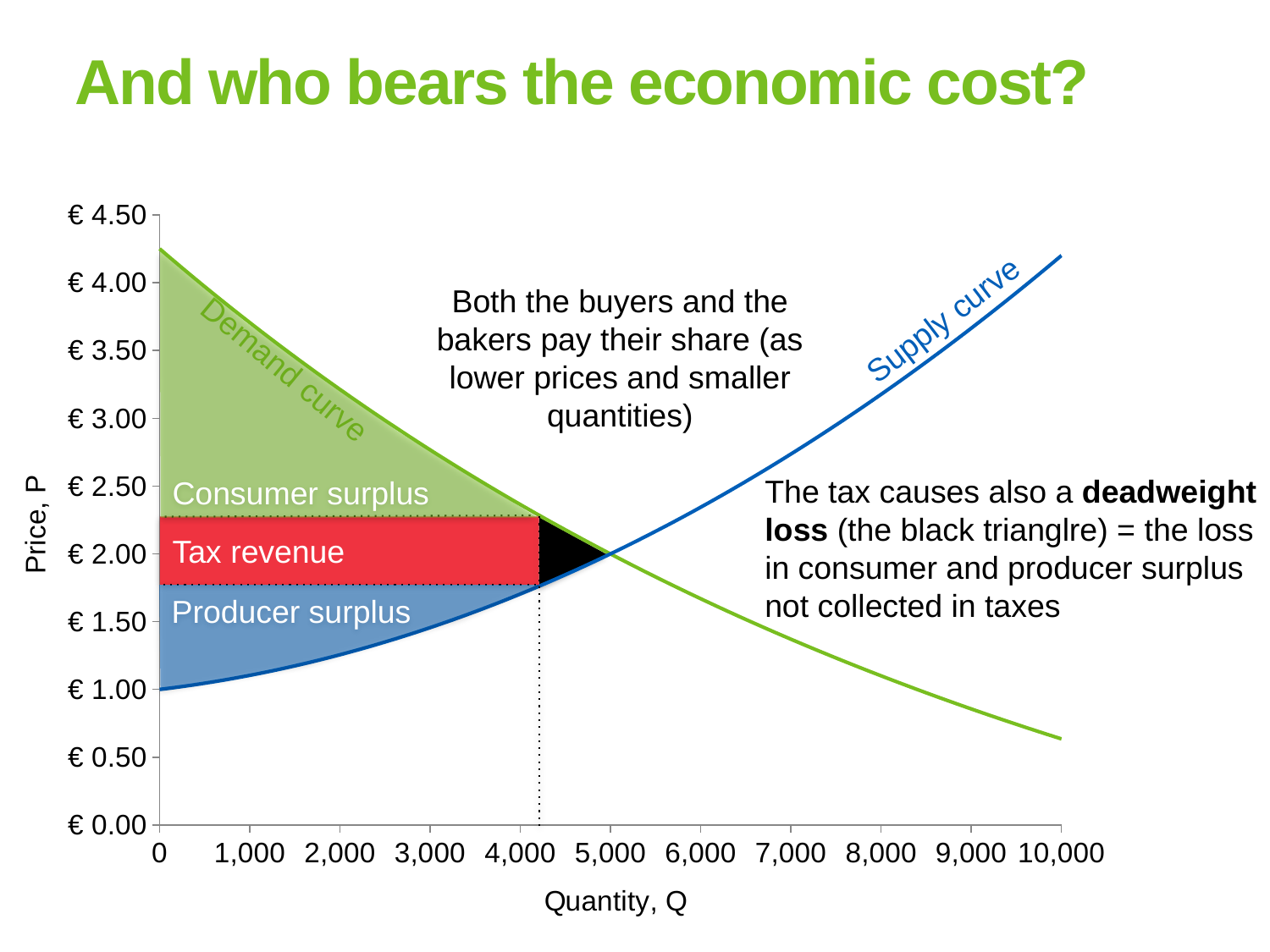
Is the quantity marked by the dotted vertical line greater or less than 5,000? less Which shaded area on the chart is coloured red? Tax revenue At quantity 10,000, which curve shows the higher price, the demand curve or the supply curve? Supply curve Does the supply curve rise or fall as quantity increases along the x axis? rise What kind of chart is shown on the slide? line chart Is the price on the demand curve at quantity 0 greater or less than € 4.00? greater At quantity 0, which curve shows the higher price, the demand curve or the supply curve? Demand curve Is the price on the supply curve at quantity 10,000 greater or less than € 4.00? greater How many curves are plotted on the chart? 2 What is the label of the y axis? Price, P Does the demand curve rise or fall as quantity increases along the x axis? fall